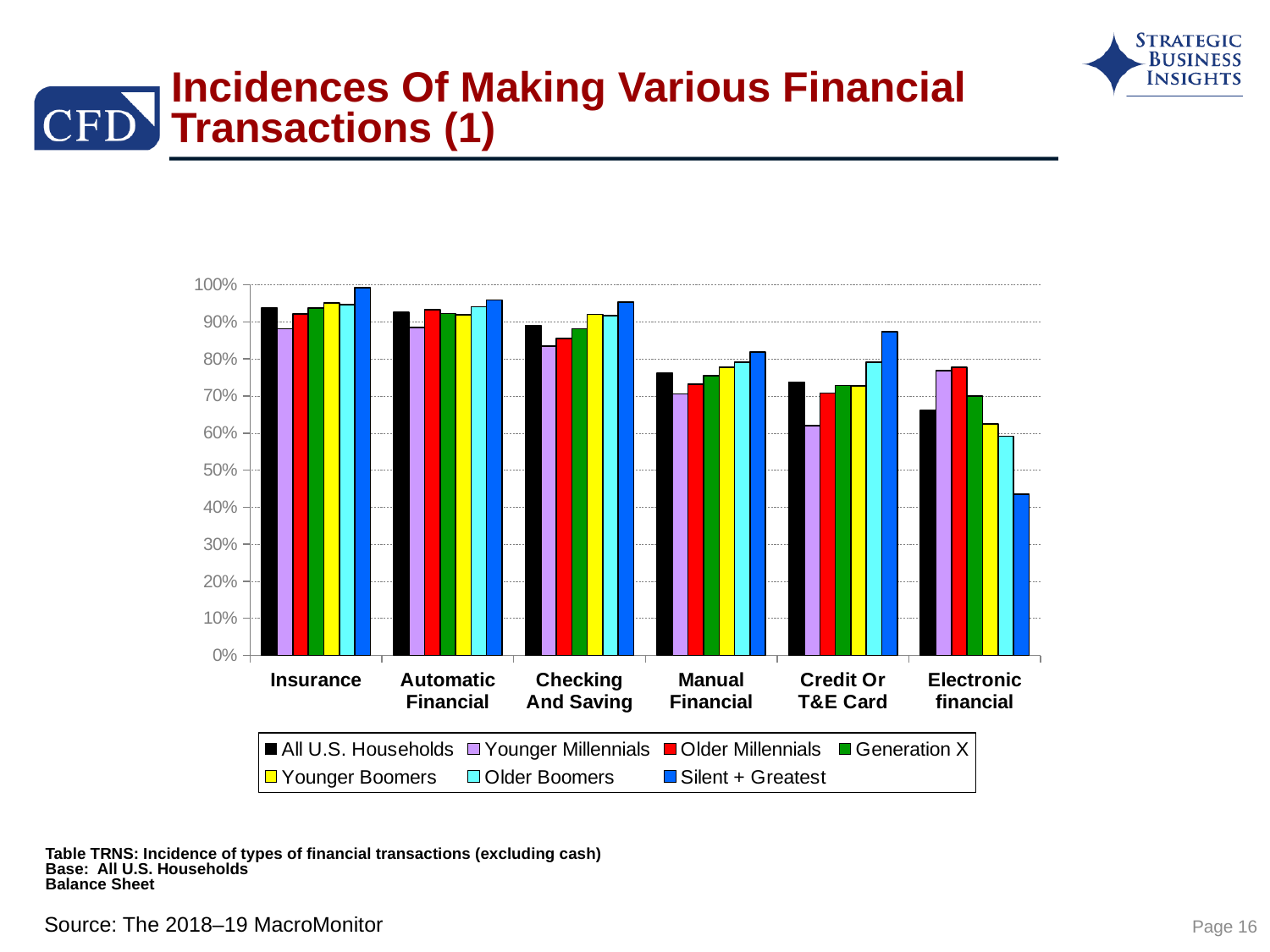
Is the value for All U.S. Households in the Electronic financial category greater or less than 70%? less Which series has the lowest value in the Electronic financial category? Silent + Greatest How many series does the legend list? 7 How many transaction categories are shown on the x axis? 6 Is the value for Silent + Greatest in the Insurance category greater or less than 90%? greater Is the value for Silent + Greatest in the Credit Or T&E Card category greater or less than 80%? greater In the Electronic financial category, which is larger: All U.S. Households or Silent + Greatest? All U.S. Households Which series has the lowest value in the Credit Or T&E Card category? Younger Millennials Which series has the highest value in the Credit Or T&E Card category? Silent + Greatest What kind of chart is shown on the slide? bar chart Do the values for All U.S. Households rise or fall moving from Insurance to Electronic financial along the x axis? fall